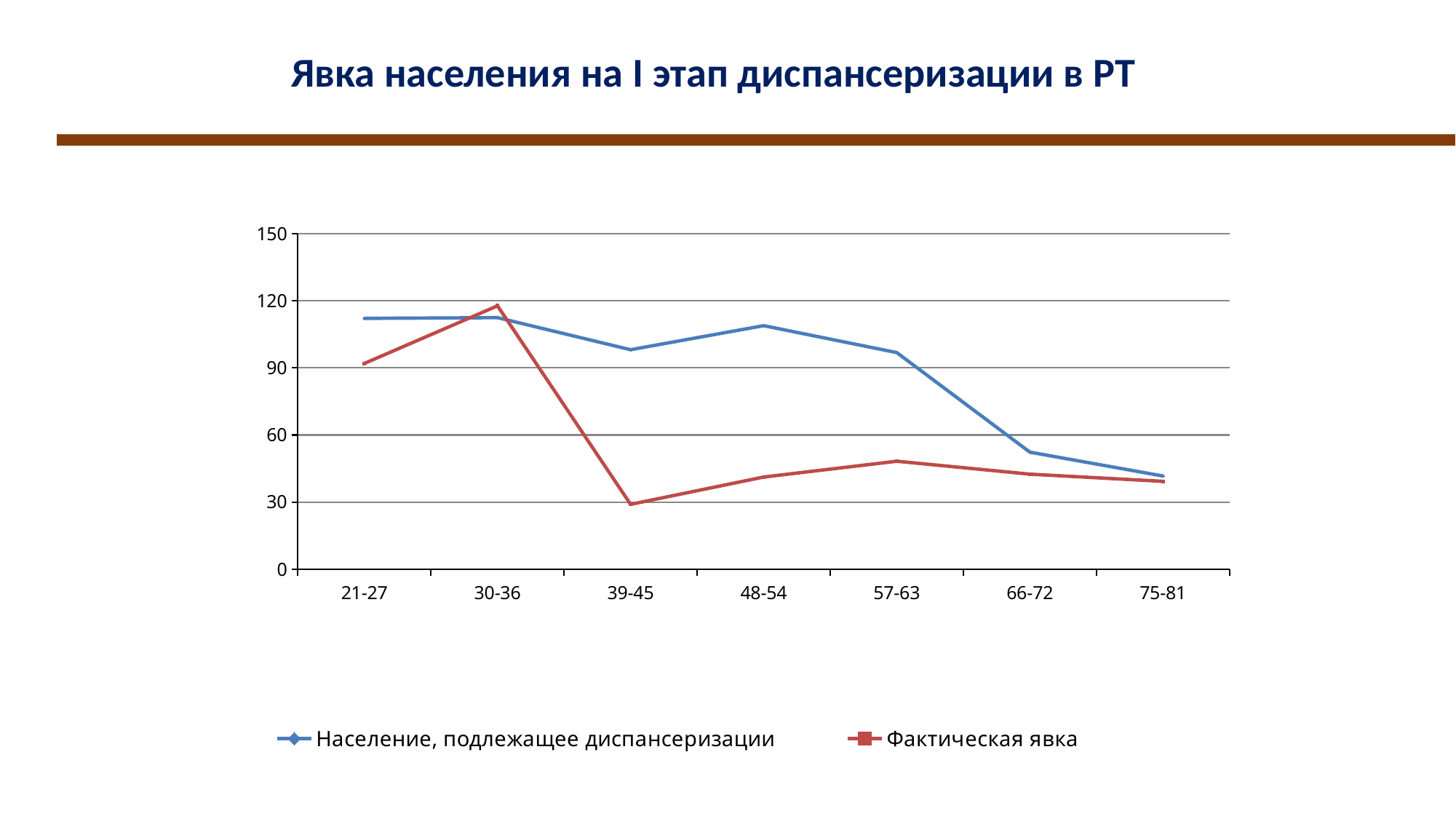
Which series is drawn in red? Фактическая явка Is the value of 'Фактическая явка' for 39-45 greater or less than 60? less What kind of chart is shown on the slide? line chart Is the value of 'Фактическая явка' for 30-36 greater or less than 90? greater What is the title of the chart? Явка населения на I этап диспансеризации в РТ For which age group is 'Фактическая явка' lowest? 39-45 For which age group is 'Фактическая явка' highest? 30-36 For the 39-45 age group, which series has the larger value? Население, подлежащее диспансеризации Is the value of 'Население, подлежащее диспансеризации' for 21-27 greater or less than 90? greater How many series does the legend list? 2 How many age-group categories are shown on the x axis? 7